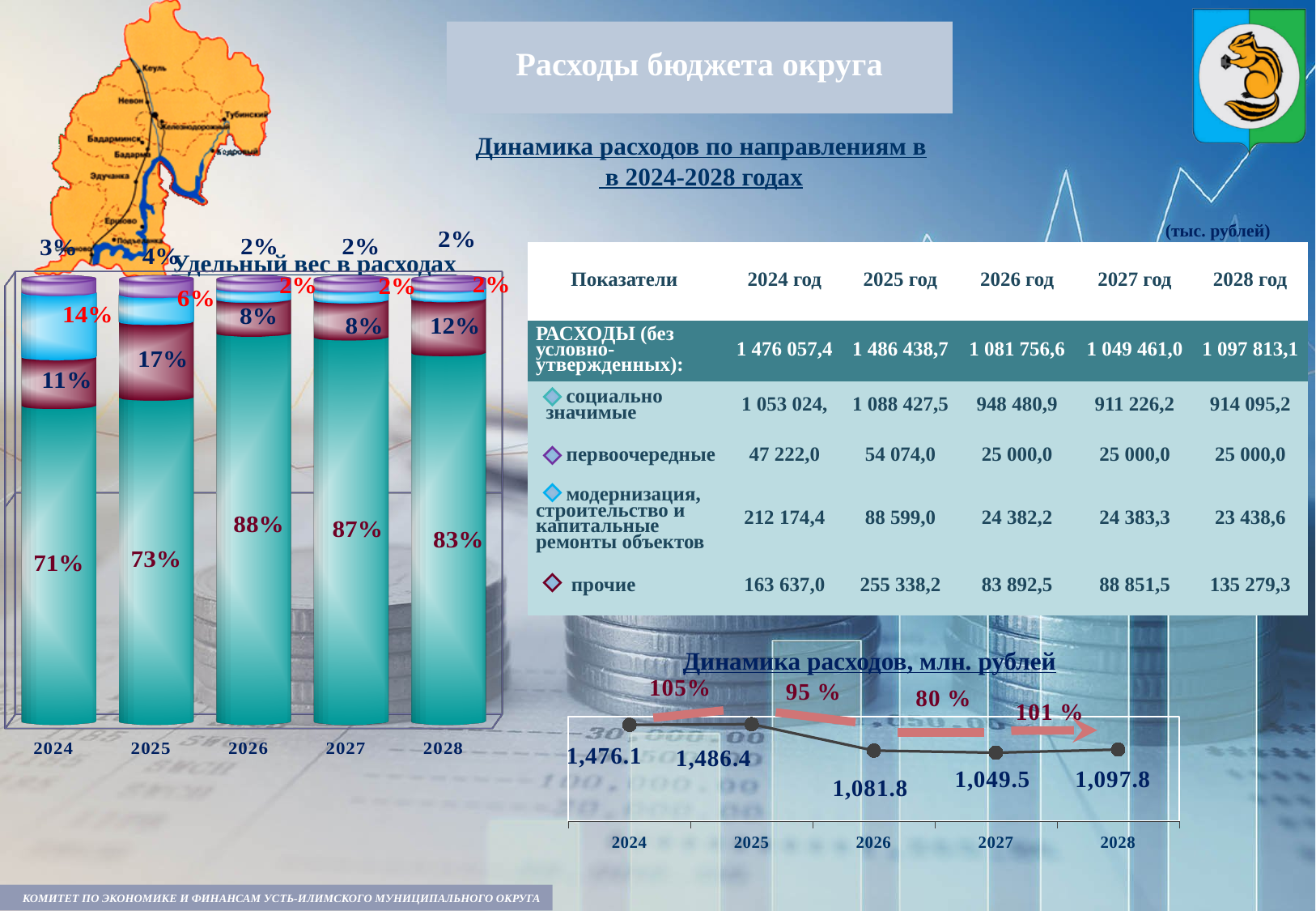
What kind of chart is 'Удельный вес в расходах'? stacked bar chart In the stacked bar chart 'Удельный вес в расходах', which year has the highest share for the largest (bottom) segment? 2026 In the line chart 'Динамика расходов, млн. рублей', what is the difference between the 2025 value and the 2026 value? 404.6 In the stacked bar chart 'Удельный вес в расходах', what is the largest segment's share for 2026? 88% In the line chart 'Динамика расходов, млн. рублей', how many years are plotted? 5 In the stacked bar chart 'Удельный вес в расходах', is the bottom segment's share larger in 2028 or in 2025? 2028 In the line chart 'Динамика расходов, млн. рублей', what is the value for 2026? 1,081.8 In the line chart 'Динамика расходов, млн. рублей', what is the value for 2024? 1,476.1 In the line chart 'Динамика расходов, млн. рублей', what percentage change is shown between 2025 and 2026? 95 % In the line chart 'Динамика расходов, млн. рублей', which year has the highest value? 2025 In the line chart 'Динамика расходов, млн. рублей', which year has the lowest value? 2027 In the stacked bar chart 'Удельный вес в расходах', what is the largest segment's share for 2024? 71%